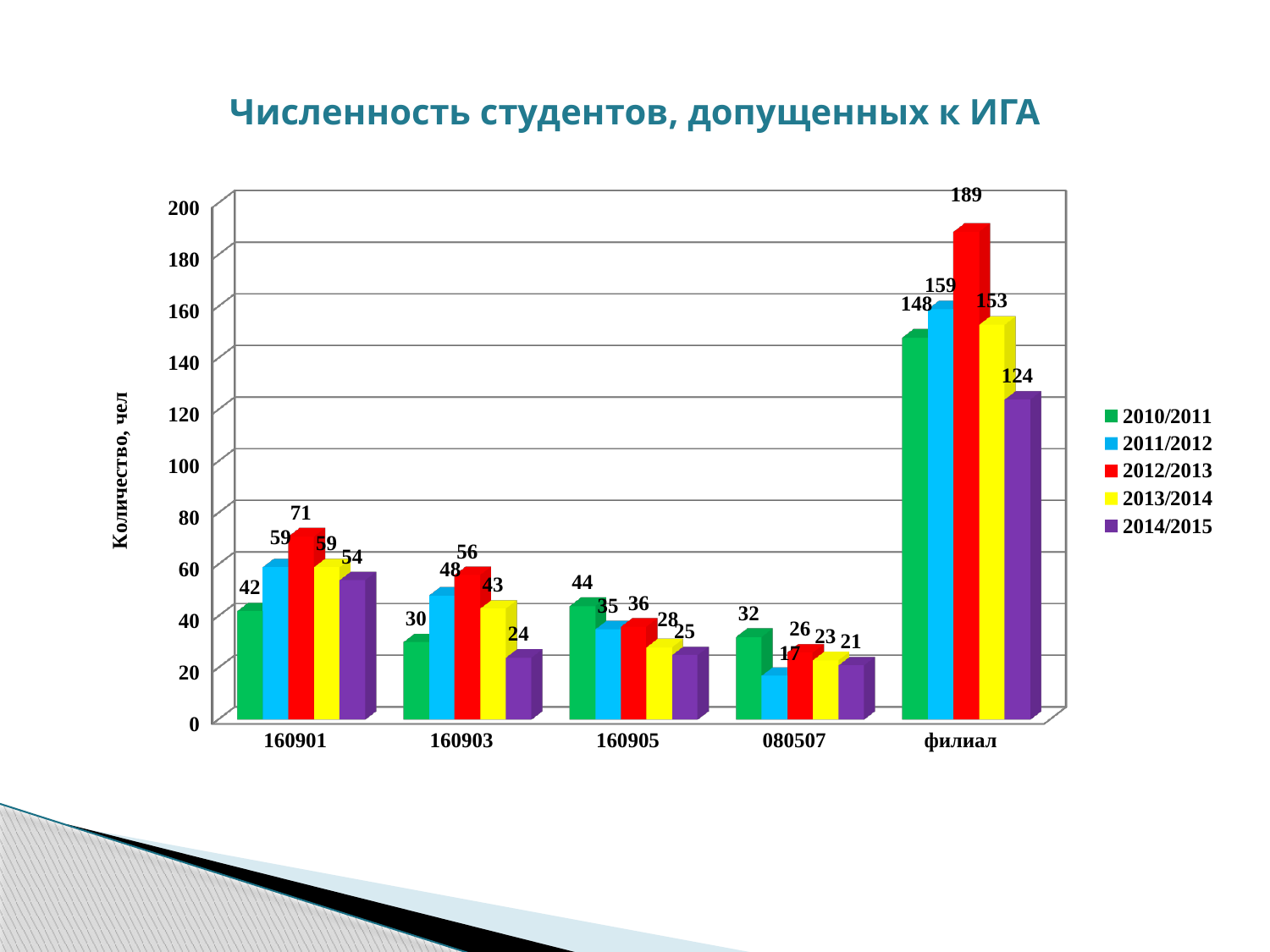
What is the value for 2014/2015 in category 160903? 24 What is the title of the chart? Численность студентов, допущенных к ИГА Which series has the lowest value in category 080507? 2011/2012 How many categories are shown on the x axis? 5 What kind of chart is shown on the slide? bar chart Which is larger: the 2010/2011 value for 160905 or the 2010/2011 value for 160903? 160905 Which series has the highest value in category 160901? 2012/2013 What is the difference between the 2012/2013 and 2014/2015 values in category филиал? 65 How many series does the legend list? 5 What is the value for 2011/2012 in category 080507? 17 Is the value for 2011/2012 in category филиал greater or less than 140? greater What is the value for 2012/2013 in category филиал? 189